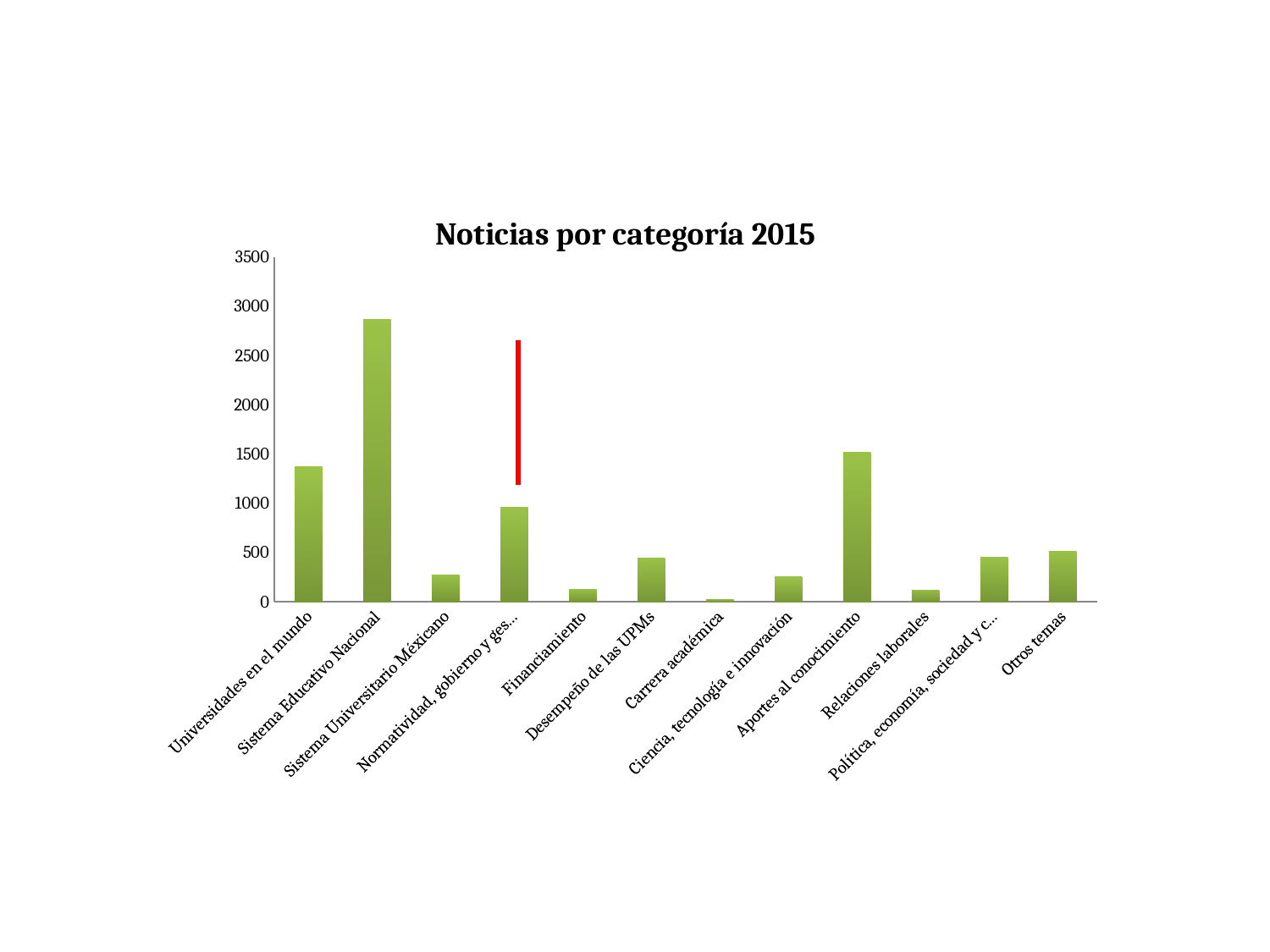
Is the value for Aportes al conocimiento greater or less than 2000? less Which is larger, the value for Universidades en el mundo or the value for Aportes al conocimiento? Aportes al conocimiento Is the value for Desempeño de las UPMs greater or less than 500? less How many categories are plotted on the x axis of the chart? 12 Is the value for Financiamiento greater or less than 500? less Which category has the lowest value in the chart? Carrera académica What is the title of the chart? Noticias por categoría 2015 Which is larger, the value for Sistema Universitario Mexicano or the value for Otros temas? Otros temas What kind of chart is shown on the slide? Bar chart Which category has the highest value in the chart? Sistema Educativo Nacional